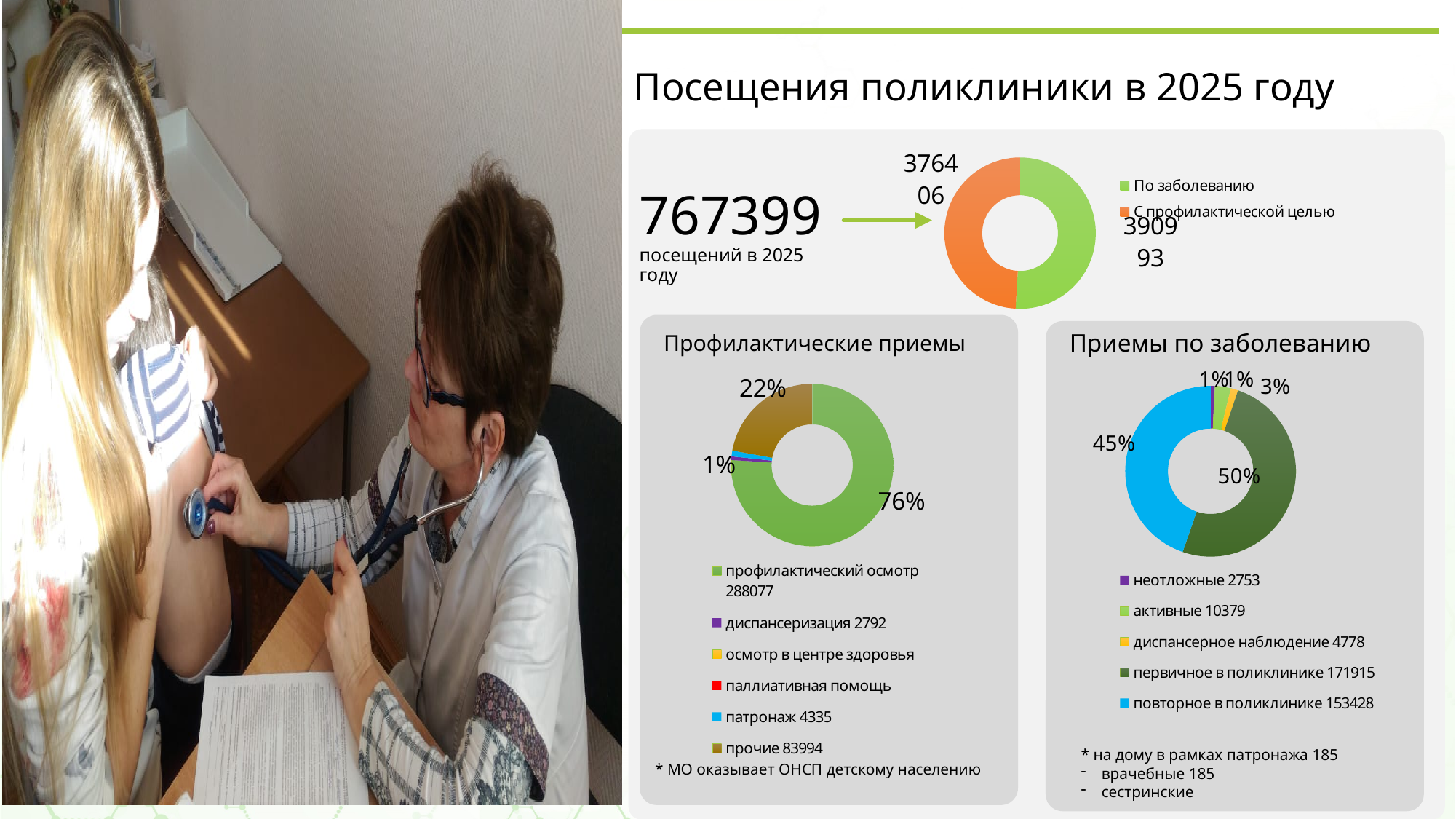
In the 'Профилактические приемы' chart, what is the value for 'профилактический осмотр'? 288077 In the 'Приемы по заболеванию' chart, what is the value for 'первичное в поликлинике'? 171915 How many entries does the legend of the top donut chart (next to 767399) list? 2 What kind of chart is used in the 'Профилактические приемы' panel? Donut (pie) chart In the 'Приемы по заболеванию' chart, which is larger: 'активные' or 'диспансерное наблюдение'? активные In the 'Приемы по заболеванию' chart, which category has the lowest value? неотложные In the 'Приемы по заболеванию' chart, what is the difference between 'первичное в поликлинике' and 'повторное в поликлинике'? 18487 In the 'Профилактические приемы' chart, what percentage share is shown for the largest slice? 76% In the 'Профилактические приемы' chart, what is the value for 'прочие'? 83994 In the 'Приемы по заболеванию' chart, what percentage share is shown for the 'повторное в поликлинике' slice? 45% In the 'Приемы по заболеванию' chart, what is the value for 'повторное в поликлинике'? 153428 How many entries does the legend of the 'Профилактические приемы' chart list? 6